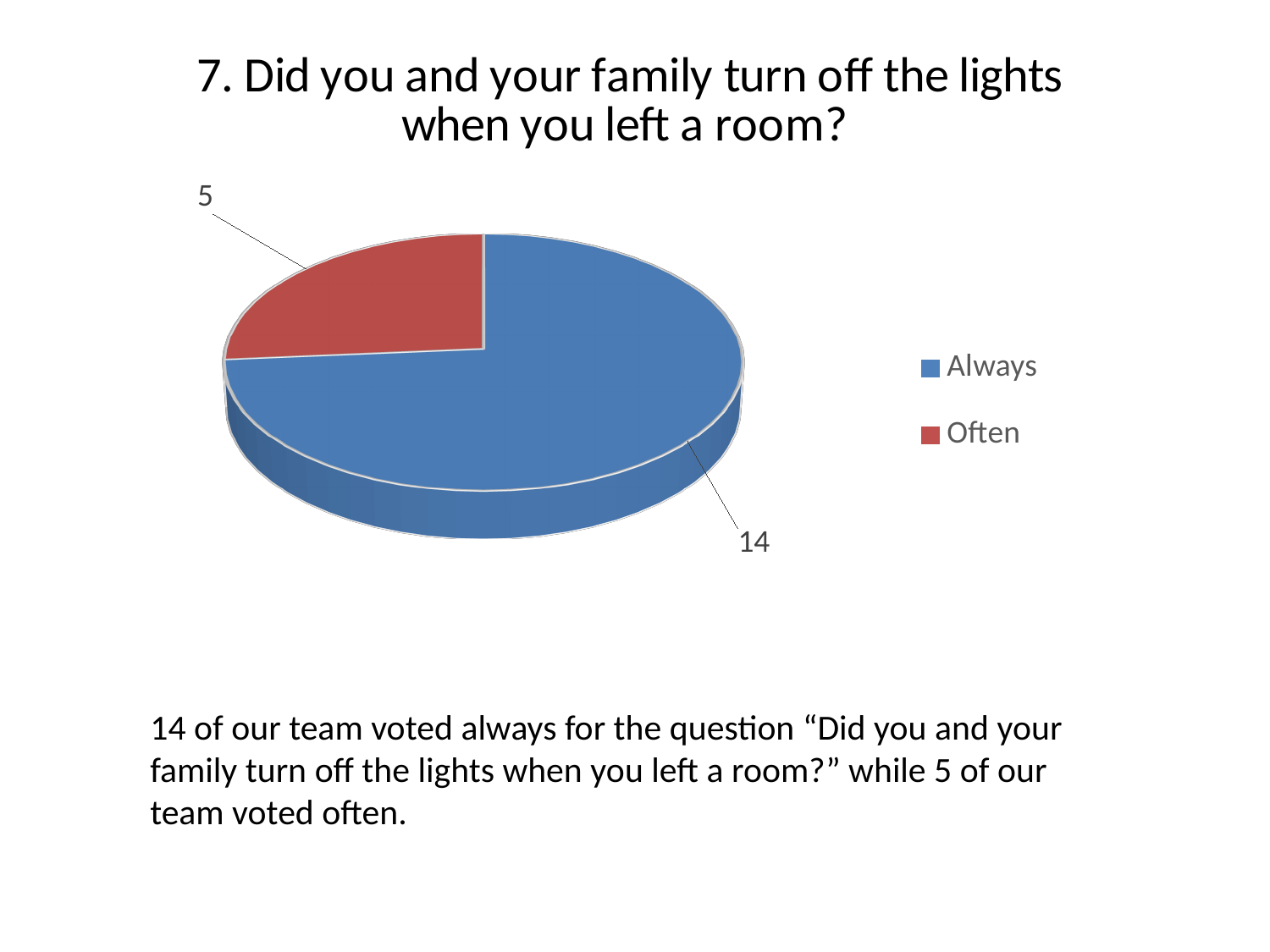
Which category has the largest slice of the pie? Always What colour is the Often slice? red Which category has the smallest slice of the pie? Often What is the difference between the Always and Often values? 9 What kind of chart is shown on the slide? pie chart How many people voted Always? 14 What is the total of all slices in the pie chart? 19 How many people voted Often? 5 How many categories does the pie chart have? 2 How many entries does the legend list? 2 Which is larger, the value for Always or the value for Often? Always What is the title of the chart? 7. Did you and your family turn off the lights when you left a room?